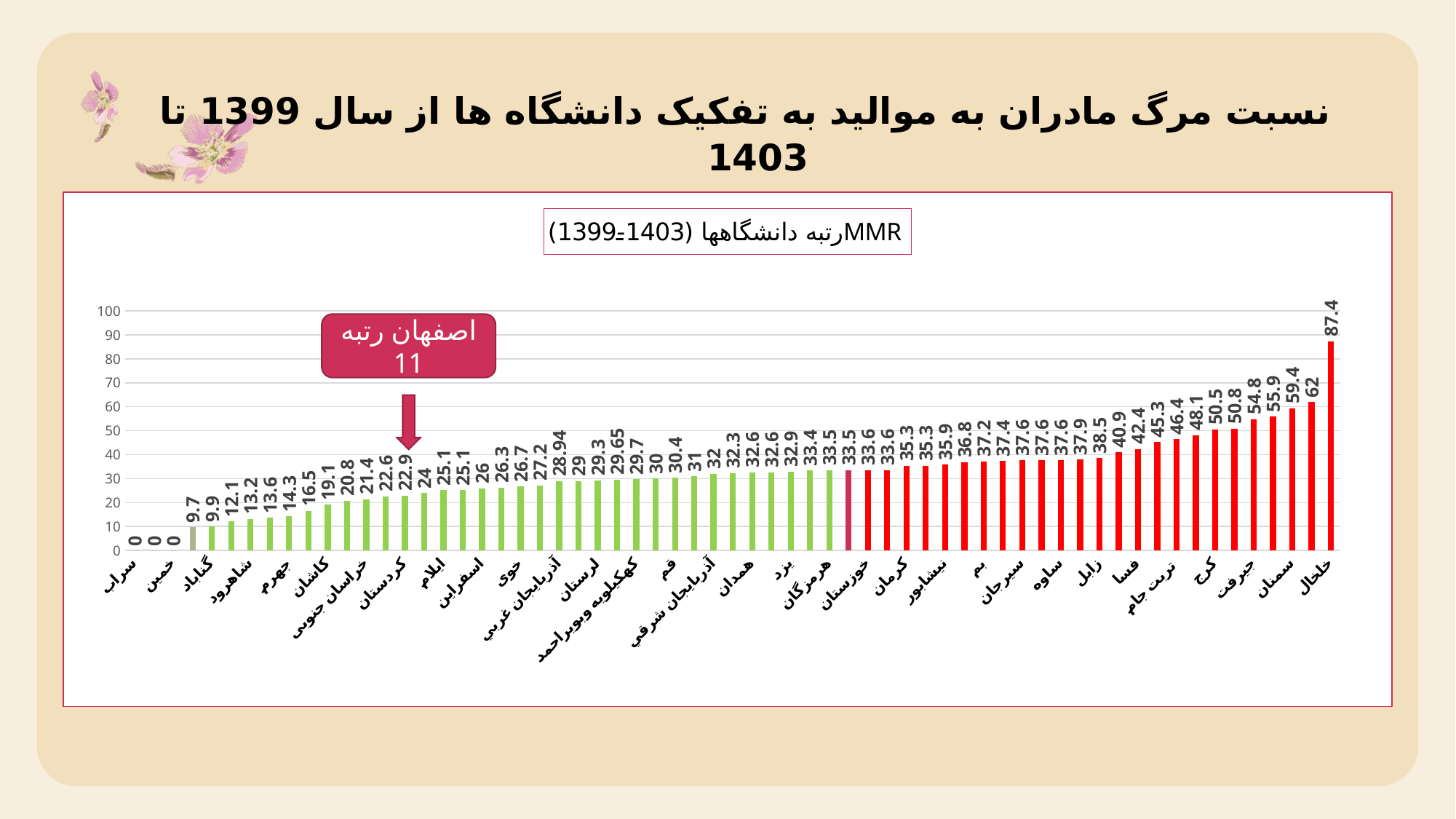
What kind of chart is shown on the slide? bar chart What is the value of the second-tallest bar in the chart? 62 What is the difference between the tallest bar (87.4) and the second-tallest bar (62)? 25.4 Which has a larger value, خلخال or سمنان? خلخال Do the values generally rise or fall from left to right along the x axis? rise Is the value for خلخال greater or less than 80? greater What is the value for سراب, the first category on the left? 0 Which university has the highest MMR value in the chart? خلخال What is the highest value shown in the chart? 87.4 What is the lowest value shown in the chart? 0 How many bars in the chart have a value of 0? 3 What does the callout box above the chart say? اصفهان رتبه 11